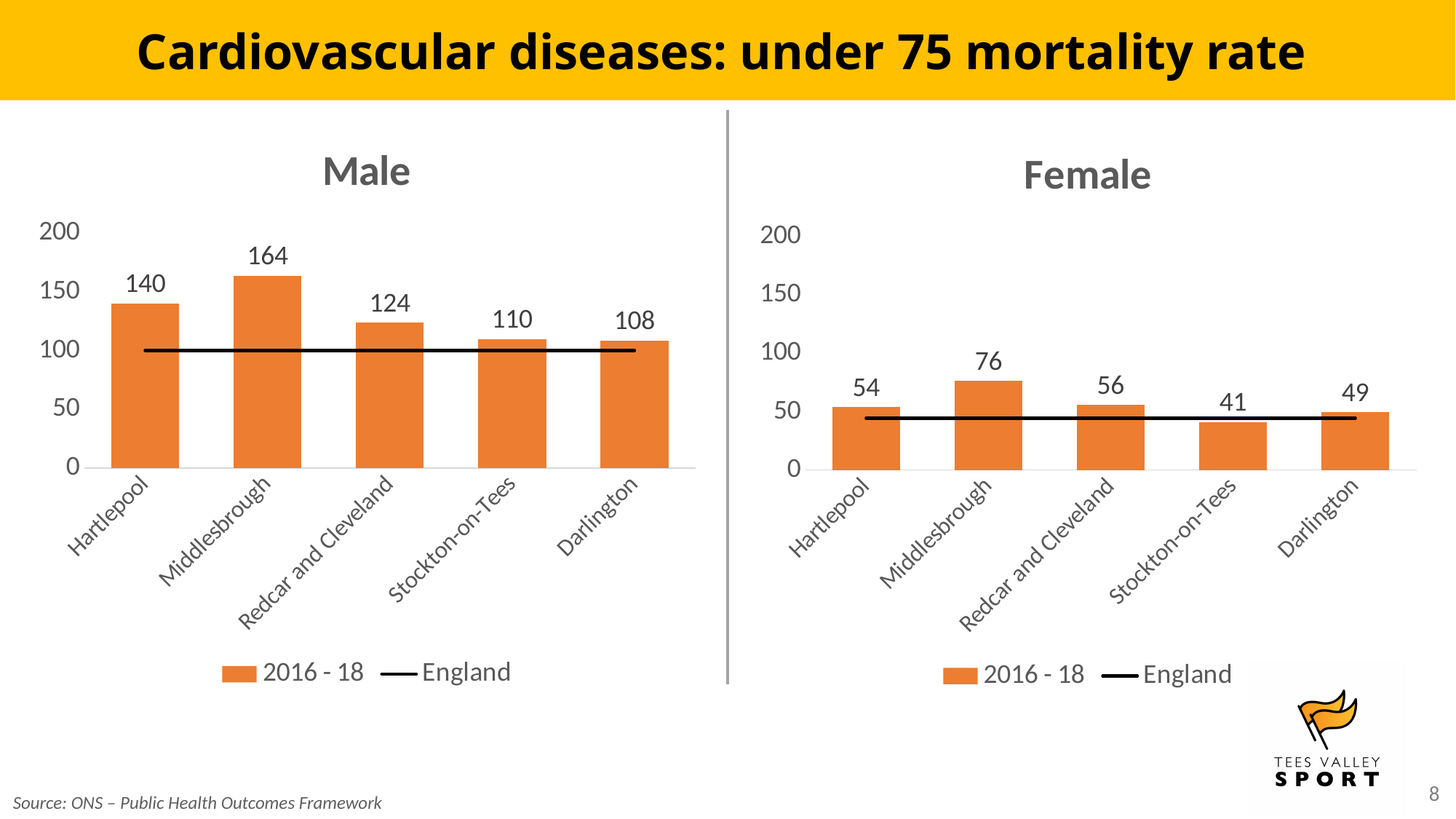
How many entries does the legend of the Male chart list? 2 In the Male chart, which area has the highest value? Middlesbrough In the Male chart, is the England line greater or less than 150? less In the Male chart, what does the black horizontal line represent according to the legend? England In the Male chart, what is the difference between Middlesbrough and Darlington? 56 In the Male chart, what is the value for Middlesbrough? 164 How many areas are shown in the Female chart? 5 In the Female chart, which is larger, Redcar and Cleveland or Darlington? Redcar and Cleveland In the Female chart, what is the value for Stockton-on-Tees? 41 In the Female chart, which area has the lowest value? Stockton-on-Tees In the Female chart, what is the difference between Middlesbrough and Hartlepool? 22 What type of chart is the Male chart? bar chart